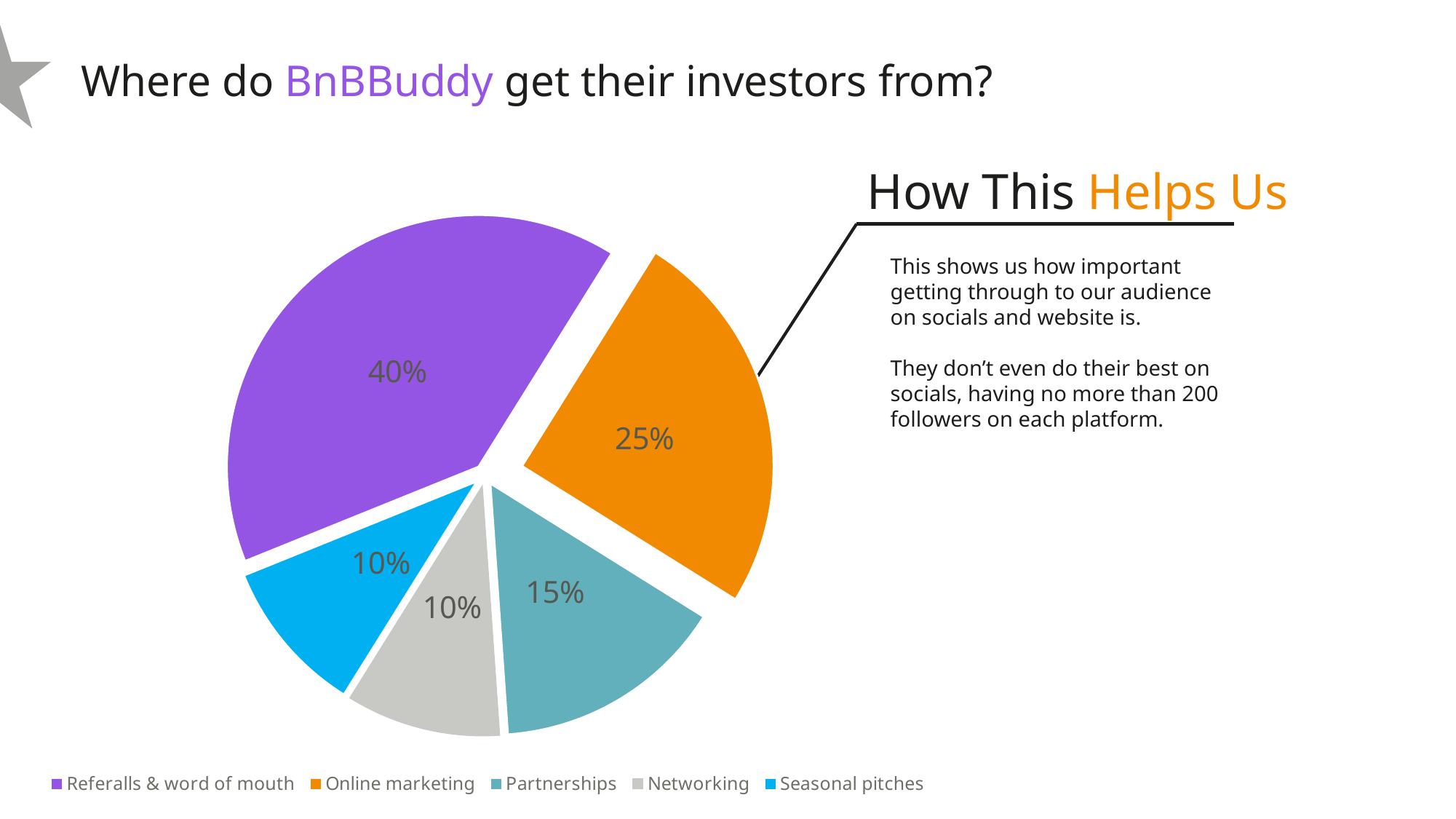
What share of investors comes from Partnerships? 15% What share of investors comes from Online marketing? 25% What is the difference in percentage points between Referalls & word of mouth and Online marketing? 15 What share of investors comes from Seasonal pitches? 10% How many entries does the legend list? 5 What kind of chart is shown on the slide? pie chart How many categories does the pie chart show? 5 Which source accounts for the largest share of investors? Referalls & word of mouth What share of investors comes from Networking? 10% Which is larger, the share for Partnerships or the share for Networking? Partnerships What colour is the Online marketing slice? orange What share of investors comes from Referalls & word of mouth? 40%